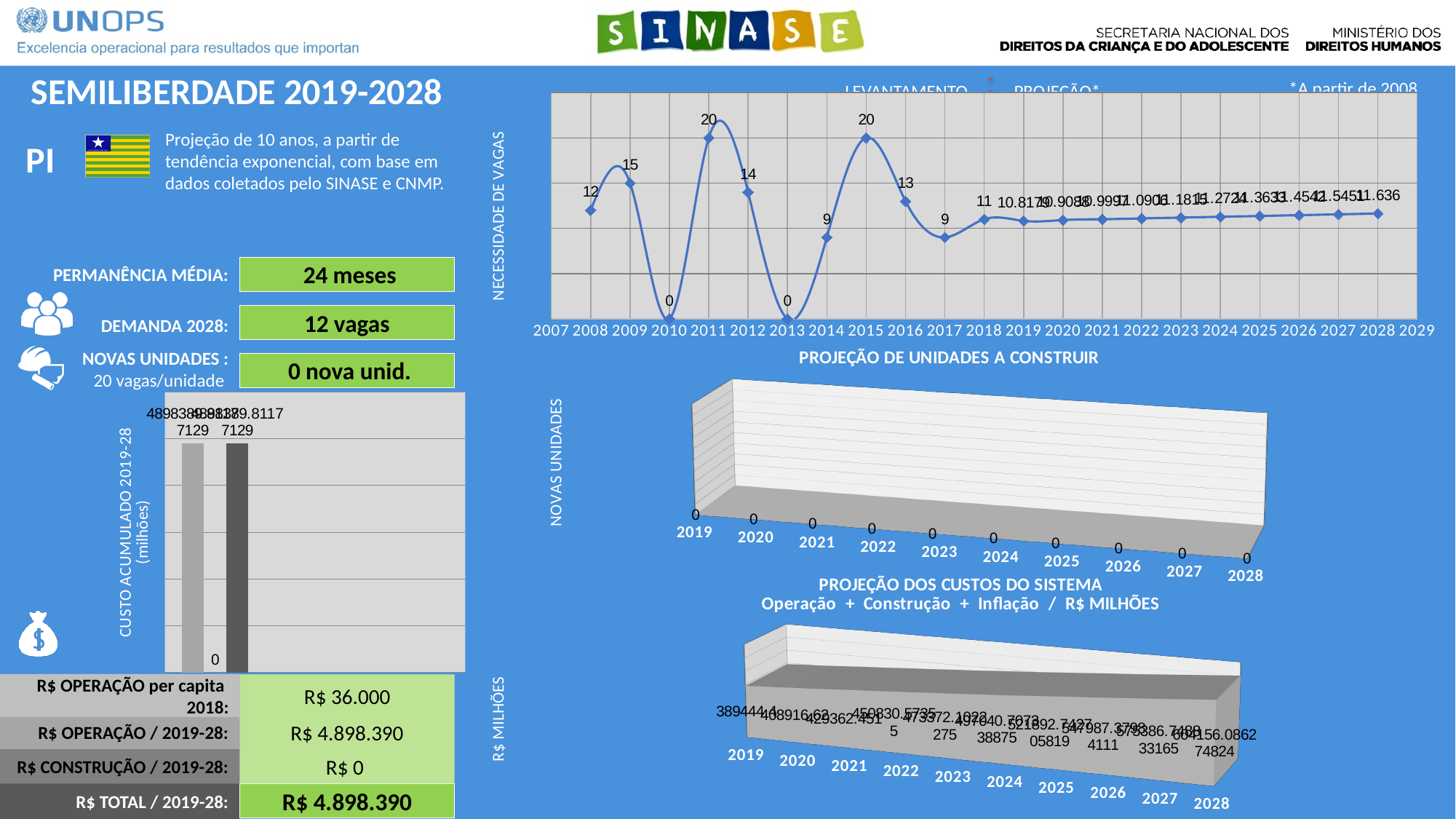
In the NECESSIDADE DE VAGAS line chart, what is the value for 2008? 12 In the NECESSIDADE DE VAGAS line chart, which years have the lowest value? 2010 and 2013 In the PROJEÇÃO DE UNIDADES A CONSTRUIR chart, what is the value for 2024? 0 In the NECESSIDADE DE VAGAS line chart, what is the value for 2016? 13 In the NECESSIDADE DE VAGAS line chart, which is larger, the value for 2012 or the value for 2014? 2012 What kind of chart is the PROJEÇÃO DE UNIDADES A CONSTRUIR chart? area chart What kind of chart is the NECESSIDADE DE VAGAS chart? line chart In the NECESSIDADE DE VAGAS line chart, what is the difference between the values for 2009 and 2008? 3 In the NECESSIDADE DE VAGAS line chart, what is the value for 2028? 11.636 In the NECESSIDADE DE VAGAS line chart, what is the value for 2011? 20 How many years are shown on the x axis of the PROJEÇÃO DE UNIDADES A CONSTRUIR chart? 10